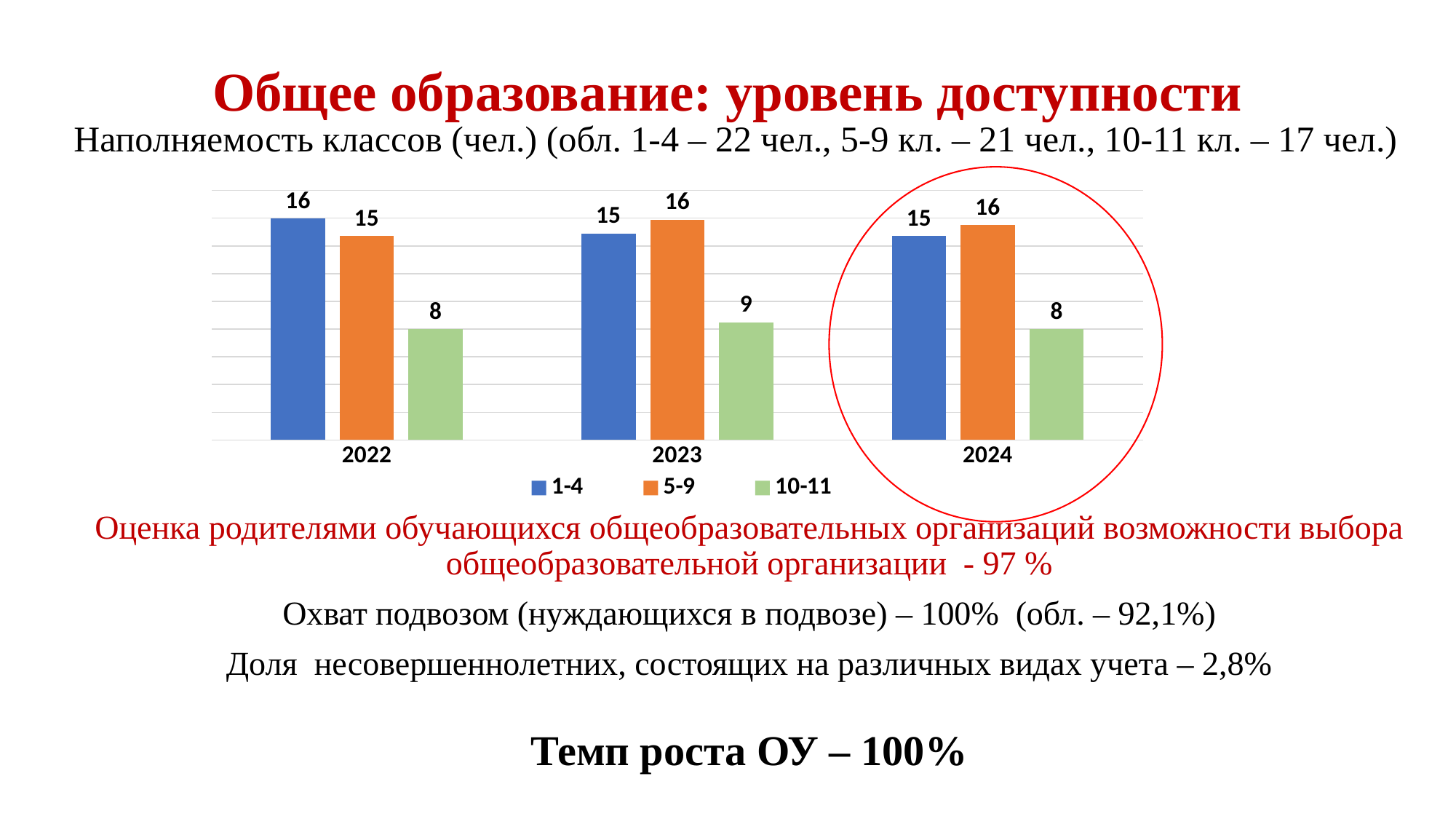
Which is larger in 2024: the 1-4 value or the 5-9 value? 5-9 What is the difference between the 1-4 and 10-11 values in 2022? 8 What is the value for the 1-4 series in 2022? 16 What kind of chart is shown on the slide? bar chart What is the value for the 5-9 series in 2023? 16 Which series has the highest value in 2024? 5-9 Which series has the lowest value in 2022? 10-11 What is the value for the 10-11 series in 2023? 9 How many years are shown on the x axis? 3 Which year on the chart is circled in red? 2024 What is the value for the 10-11 series in 2024? 8 How many series does the legend list? 3